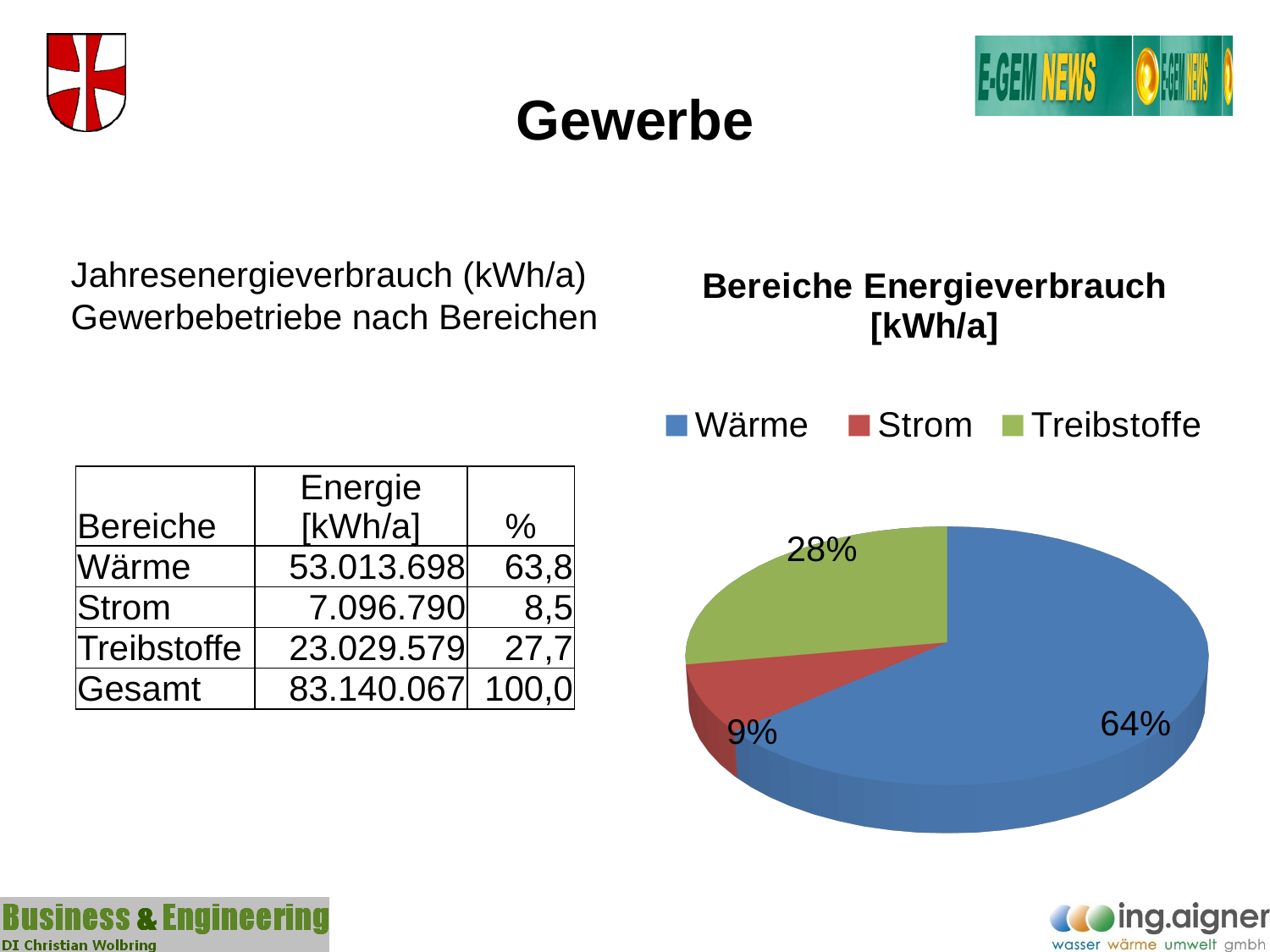
How many slices does the pie chart have? 3 What share of the pie chart does Wärme have? 64% What is the title of the pie chart? Bereiche Energieverbrauch [kWh/a] What share of the pie chart does Strom have? 9% Which colour represents Treibstoffe in the pie chart? green Which category has the largest slice in the pie chart? Wärme What is the difference in percentage points between the Wärme and Treibstoffe slices in the pie chart? 36 What share of the pie chart does Treibstoffe have? 28% How many entries does the legend of the pie chart list? 3 What type of chart is shown on the slide? pie chart Which category has the smallest slice in the pie chart? Strom Which slice is larger in the pie chart, Treibstoffe or Strom? Treibstoffe